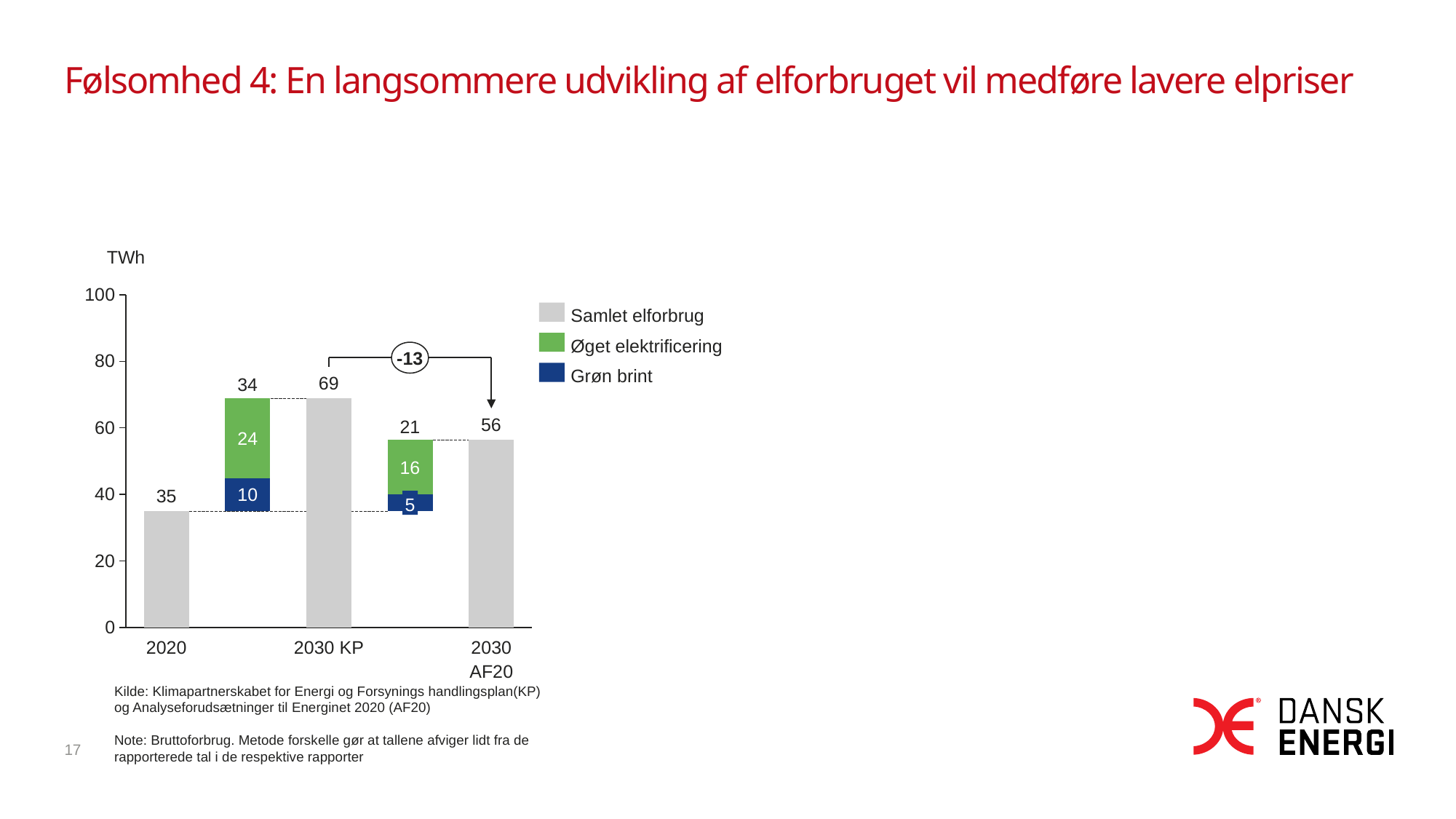
What is the value of Samlet elforbrug for 2020? 35 What is the Øget elektrificering value in the stacked bar between 2020 and 2030 KP? 24 What is the Grøn brint value in the stacked bar between 2030 KP and 2030 AF20? 5 What is the difference between Samlet elforbrug for 2030 KP and 2030 AF20? 13 What is the total of the stacked bar between 2030 KP and 2030 AF20? 21 How many series does the legend list? 3 What is the value of Samlet elforbrug for 2030 AF20? 56 Which is larger, the Grøn brint value in the first stacked bar or in the second stacked bar? The first stacked bar (10) What is the total of the stacked bar between 2020 and 2030 KP? 34 What unit is shown on the y axis? TWh Which scenario has the highest Samlet elforbrug? 2030 KP What is the value of Samlet elforbrug for 2030 KP? 69